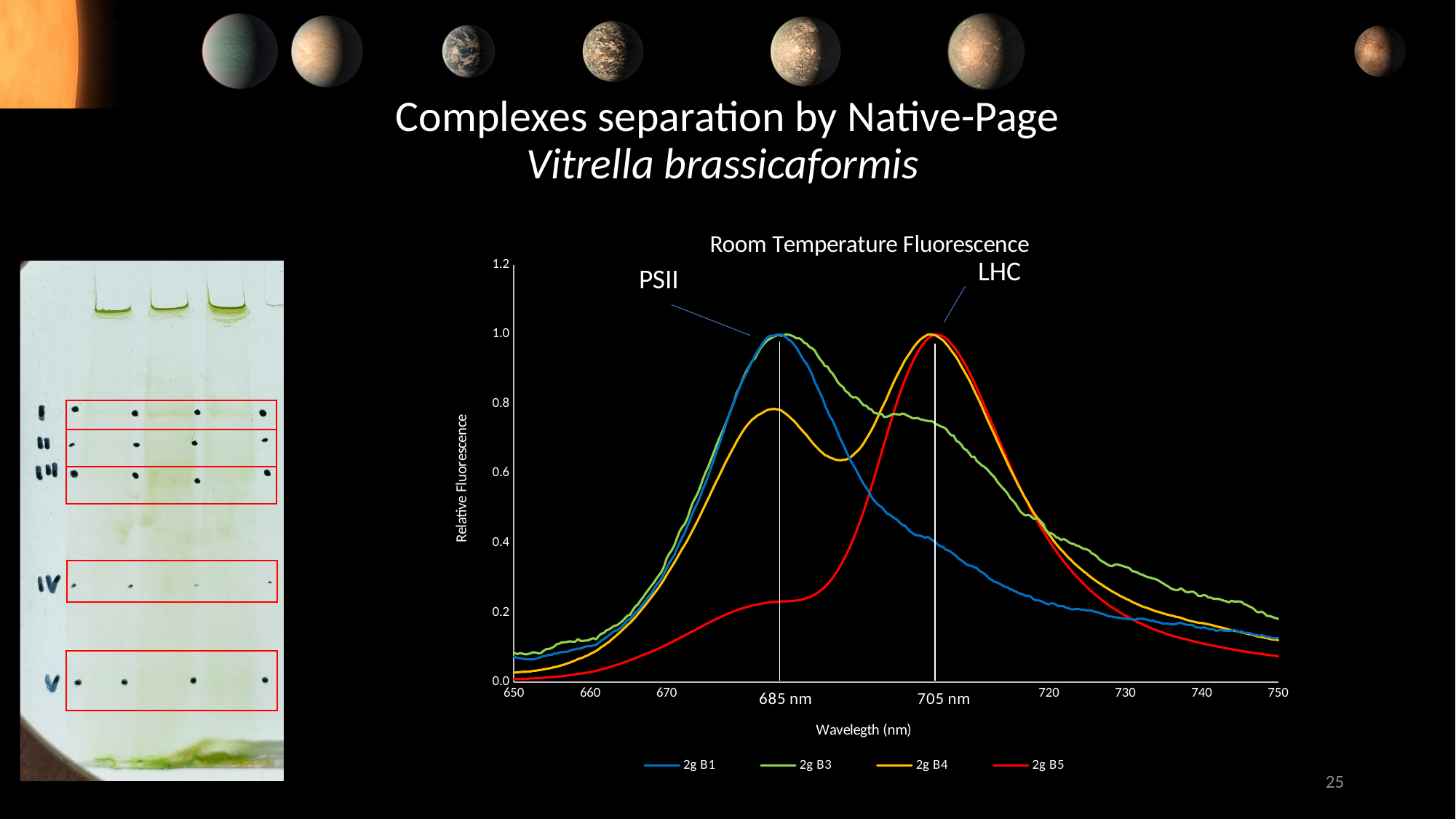
What is the label of the y axis of the chart? Relative Fluorescence At 705 nm, which series has the larger value, 2g B5 or 2g B1? 2g B5 Is the value for 2g B5 at 750 nm greater or less than 0.2? less At which wavelength is the PSII peak marked on the chart? 685 nm Is the value for 2g B3 at 705 nm greater or less than 0.6? greater What type of chart is shown on the slide? line chart How many series does the chart legend list? 4 At 685 nm, which series has the larger value, 2g B1 or 2g B5? 2g B1 Does the 2g B1 series rise or fall between 685 nm and 750 nm? fall Is the value for 2g B5 at 685 nm greater or less than 0.4? less What is the title of the chart? Room Temperature Fluorescence At which wavelength is the LHC peak marked on the chart? 705 nm